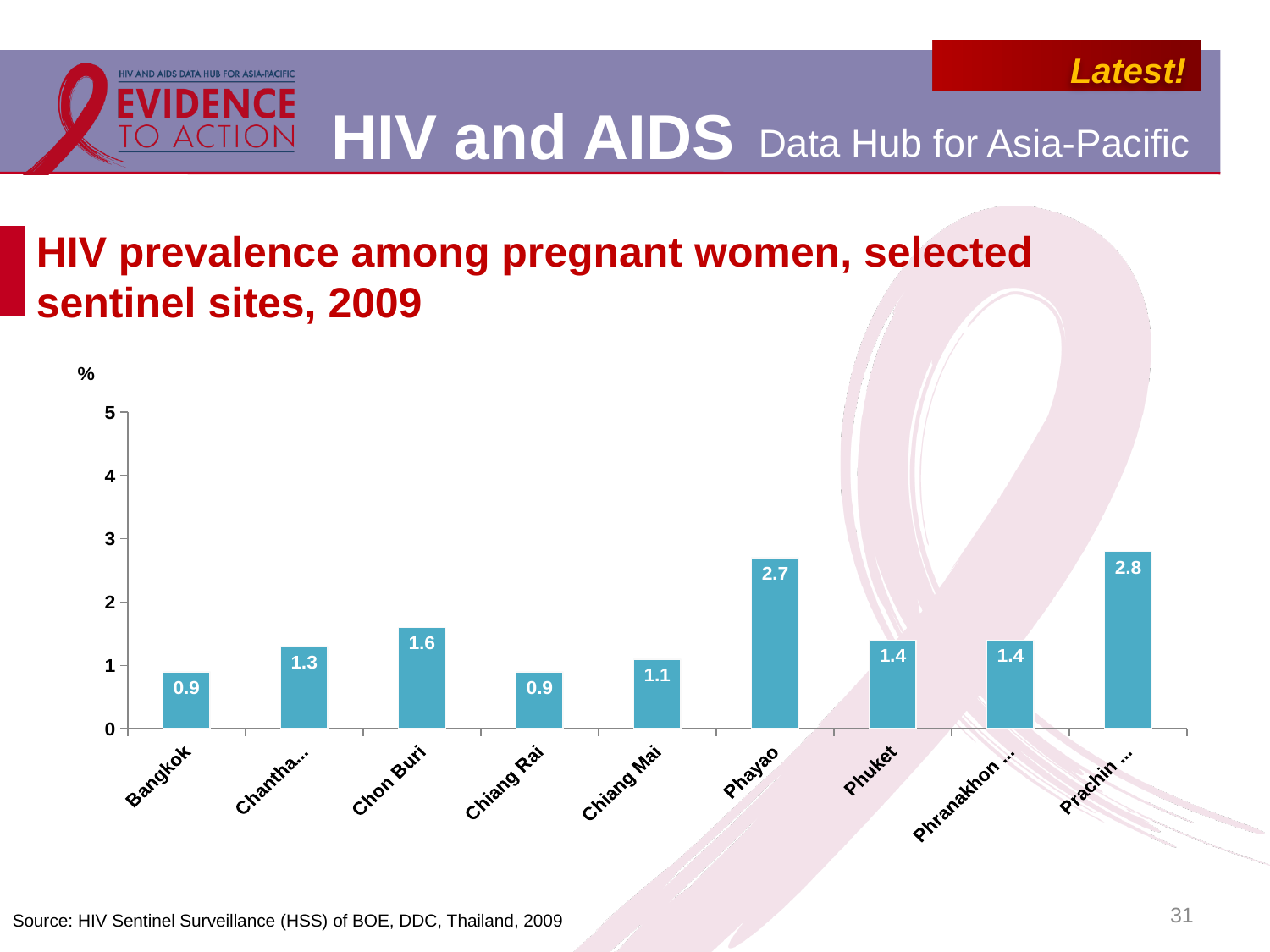
What type of chart is used on this slide? Bar chart What is the difference between the values for Chon Buri and Bangkok? 0.7 What is the value shown for Phuket? 1.4 How many sentinel sites (bars) are shown in the chart? 9 What is the highest value labelled on any bar in the chart? 2.8 Which has a higher value, Phayao or Phuket? Phayao What is the value shown for Phayao? 2.7 What is the difference between the values for Phayao and Chon Buri? 1.1 Is the value for Phayao greater or less than 2? greater What is the value shown for Chiang Mai? 1.1 What is the value shown for Chon Buri? 1.6 What is the HIV prevalence value shown for Bangkok? 0.9